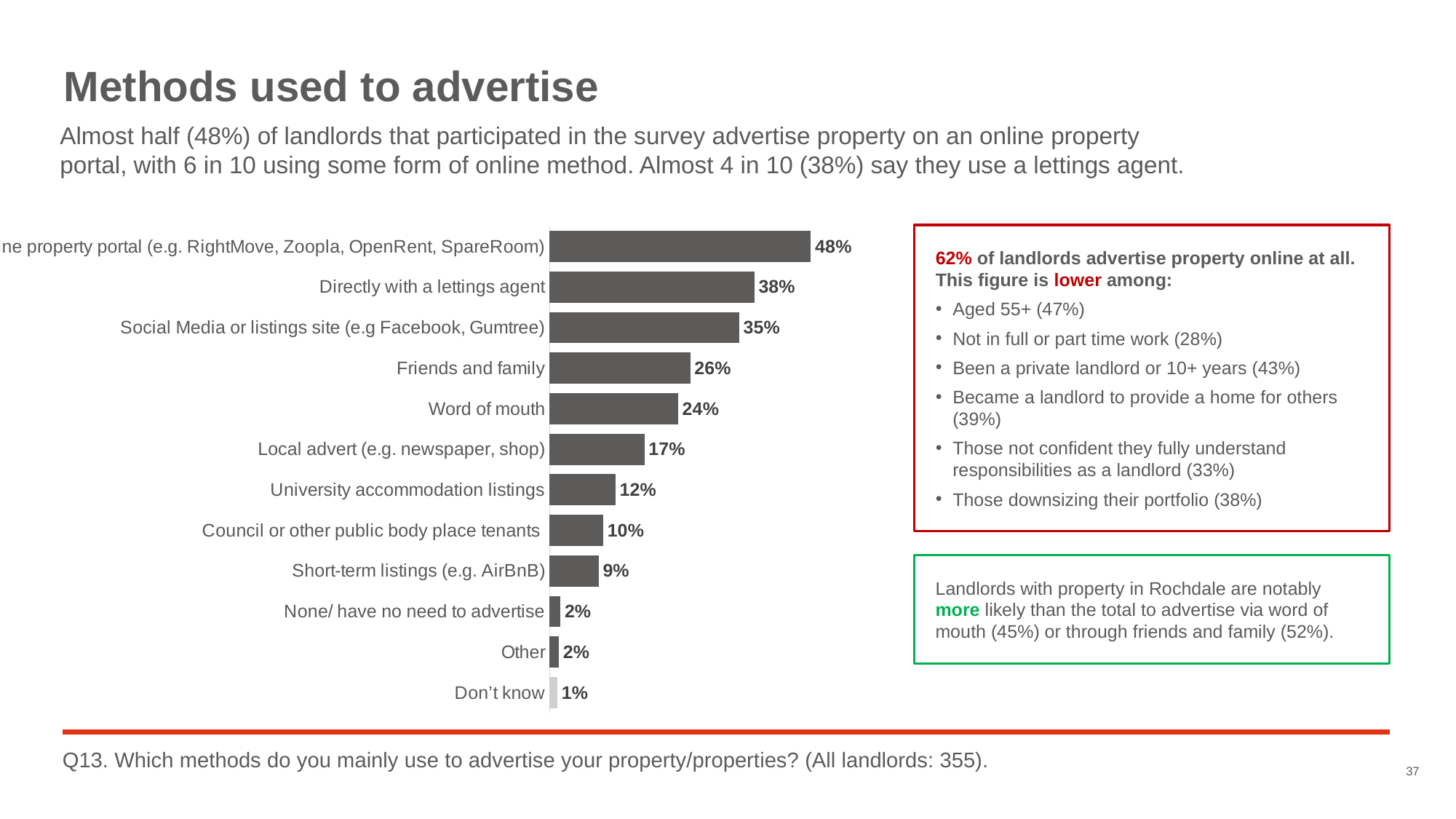
How many categories are shown in the bar chart? 12 Which is larger: the value for Council or other public body place tenants or the value for Short-term listings? Council or other public body place tenants Which category has the lowest value in the chart? Don't know What percentage of landlords use University accommodation listings? 12% What is the difference between Social Media or listings site and Local advert? 18% What is the value for Short-term listings (e.g. AirBnB)? 9% What is the difference between the values for Friends and family and Word of mouth? 2% What is the value for Word of mouth? 24% What percentage of landlords advertise directly with a lettings agent? 38% What type of chart is shown on the slide? Bar chart Which advertising method has the highest percentage? Online property portal (e.g. RightMove, Zoopla, OpenRent, SpareRoom) What is the title of the slide containing the chart? Methods used to advertise